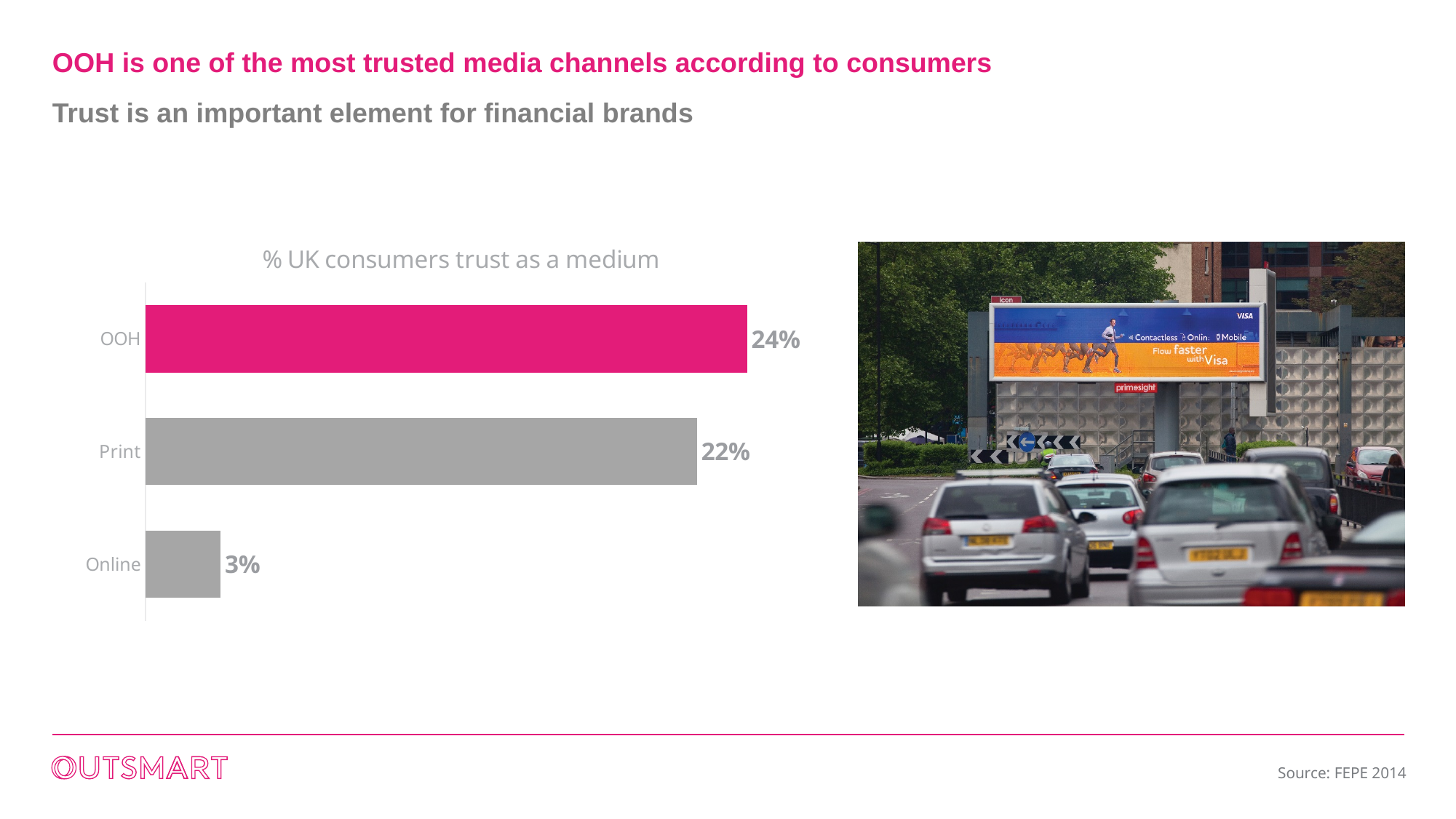
What is the difference between the Print and Online values? 19% What type of chart is shown on the slide? Bar chart What is the difference between the OOH and Print values? 2% What is the title of the chart? % UK consumers trust as a medium Which medium has the highest trust percentage? OOH Which bar is coloured pink rather than grey? OOH Which is larger, the value for Print or the value for Online? Print How many media categories are shown in the chart? 3 What is the value shown for Online? 3% What is the value shown for Print? 22% What percentage of UK consumers trust OOH as a medium? 24% Which medium has the lowest trust percentage? Online